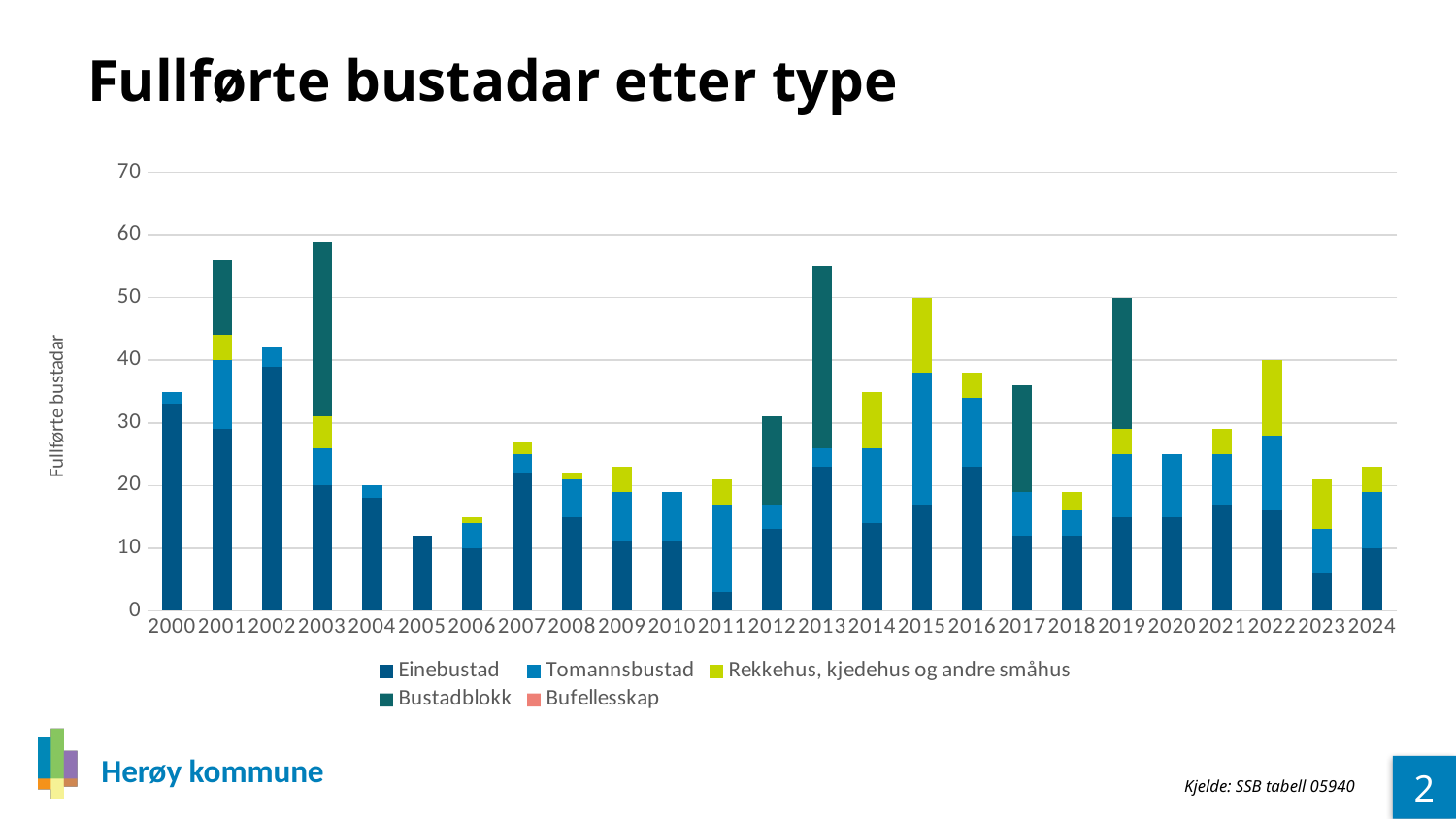
Is the total for 2017 greater or less than 40? less How many years are shown along the x axis? 25 Which year has the tallest stacked bar? 2003 Is the total for 2000 greater or less than 30? greater What is the title of the chart? Fullførte bustadar etter type How many series does the legend list? 5 Which year has the shortest stacked bar? 2005 Do the totals rise or fall from 2020 to 2022? rise Is the total for 2013 greater or less than 50? greater What kind of chart is shown on the slide? Stacked bar chart Which year has the larger total, 2001 or 2002? 2001